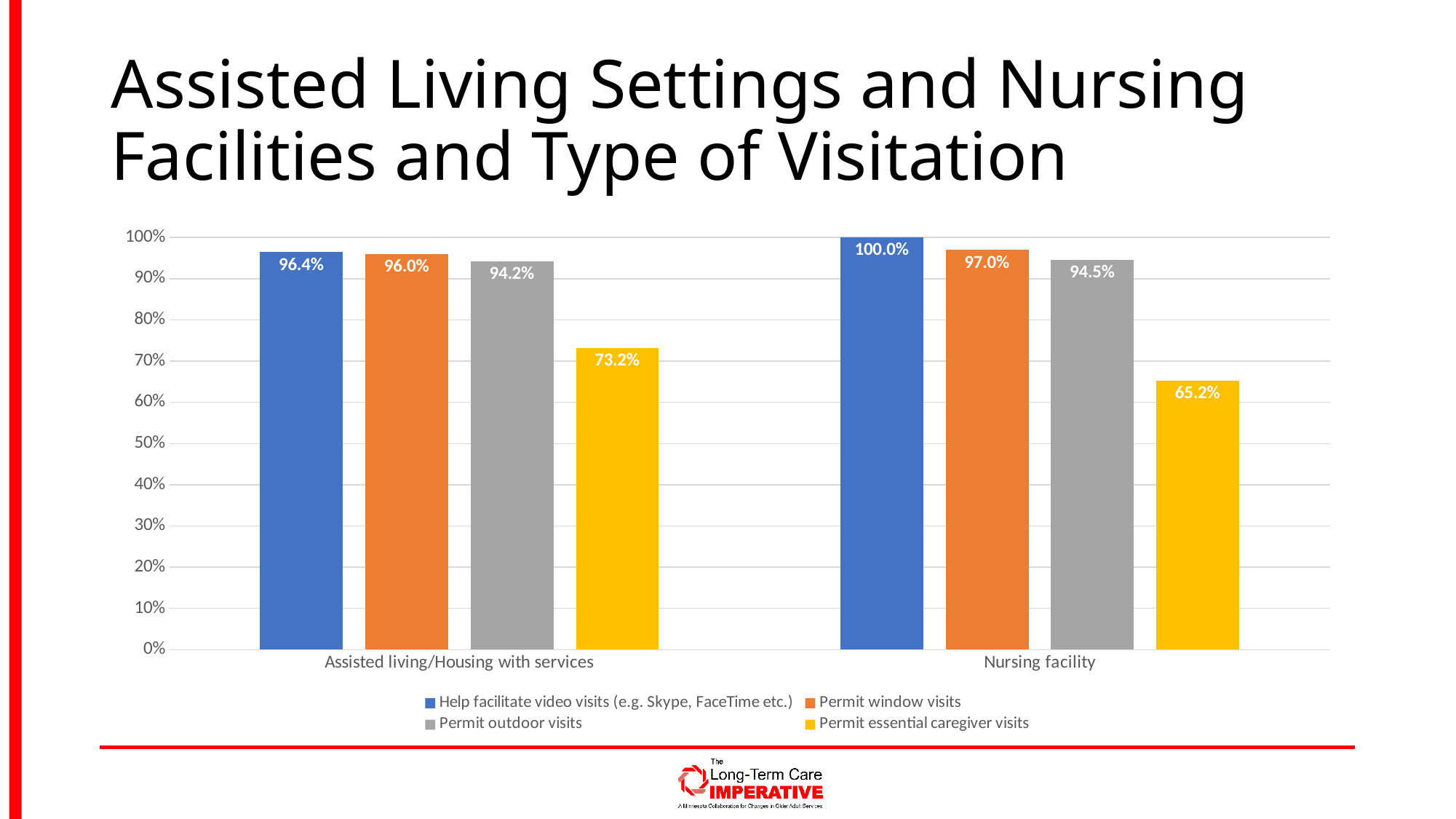
Which series has the lowest value in the Assisted living/Housing with services category? Permit essential caregiver visits What kind of chart is shown on the slide? Bar chart What is the value for 'Permit outdoor visits' in the Nursing facility category? 94.5% What is the difference between 'Permit essential caregiver visits' for Assisted living/Housing with services and for Nursing facility? 8.0% Which series has the highest value in the Nursing facility category? Help facilitate video visits (e.g. Skype, FaceTime etc.) What is the value for 'Permit essential caregiver visits' in the Nursing facility category? 65.2% How many series does the legend list? 4 Which is larger: 'Permit window visits' for Assisted living/Housing with services or for Nursing facility? Nursing facility How many categories are shown on the x axis? 2 Is the value for 'Permit essential caregiver visits' in the Nursing facility category greater or less than 70%? less What colour are the bars for 'Permit window visits'? Orange What is the value for 'Help facilitate video visits (e.g. Skype, FaceTime etc.)' in the Assisted living/Housing with services category? 96.4%